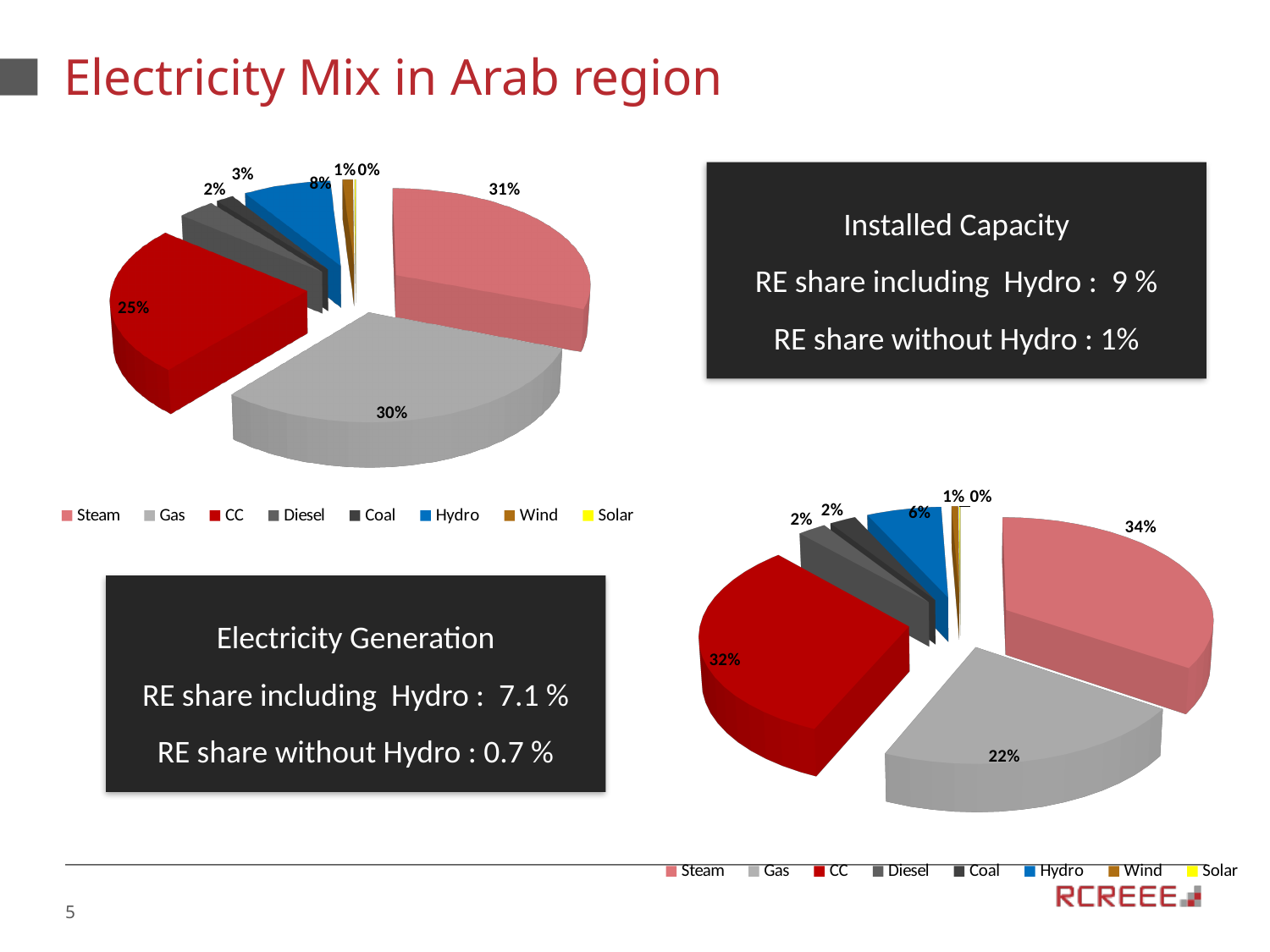
In the top-left pie chart, what share does Hydro have? 8% In the bottom-right pie chart, what is the difference between the Steam share and the Gas share? 12% In the bottom-right pie chart, what share does CC have? 32% How many categories does the legend of the top-left pie chart list? 8 What type of chart is shown in the top-left of the slide? Pie chart In the bottom-right pie chart, which is larger, the Steam share or the CC share? Steam In the top-left pie chart, what share does Steam have? 31% Which colour represents Hydro in the legends of the pie charts? Blue In the top-left pie chart, which category has the largest share? Steam In the bottom-right pie chart, which category has the largest share? Steam In the bottom-right pie chart, what share does Gas have? 22% In the top-left pie chart, what is the difference between the Gas share and the CC share? 5%